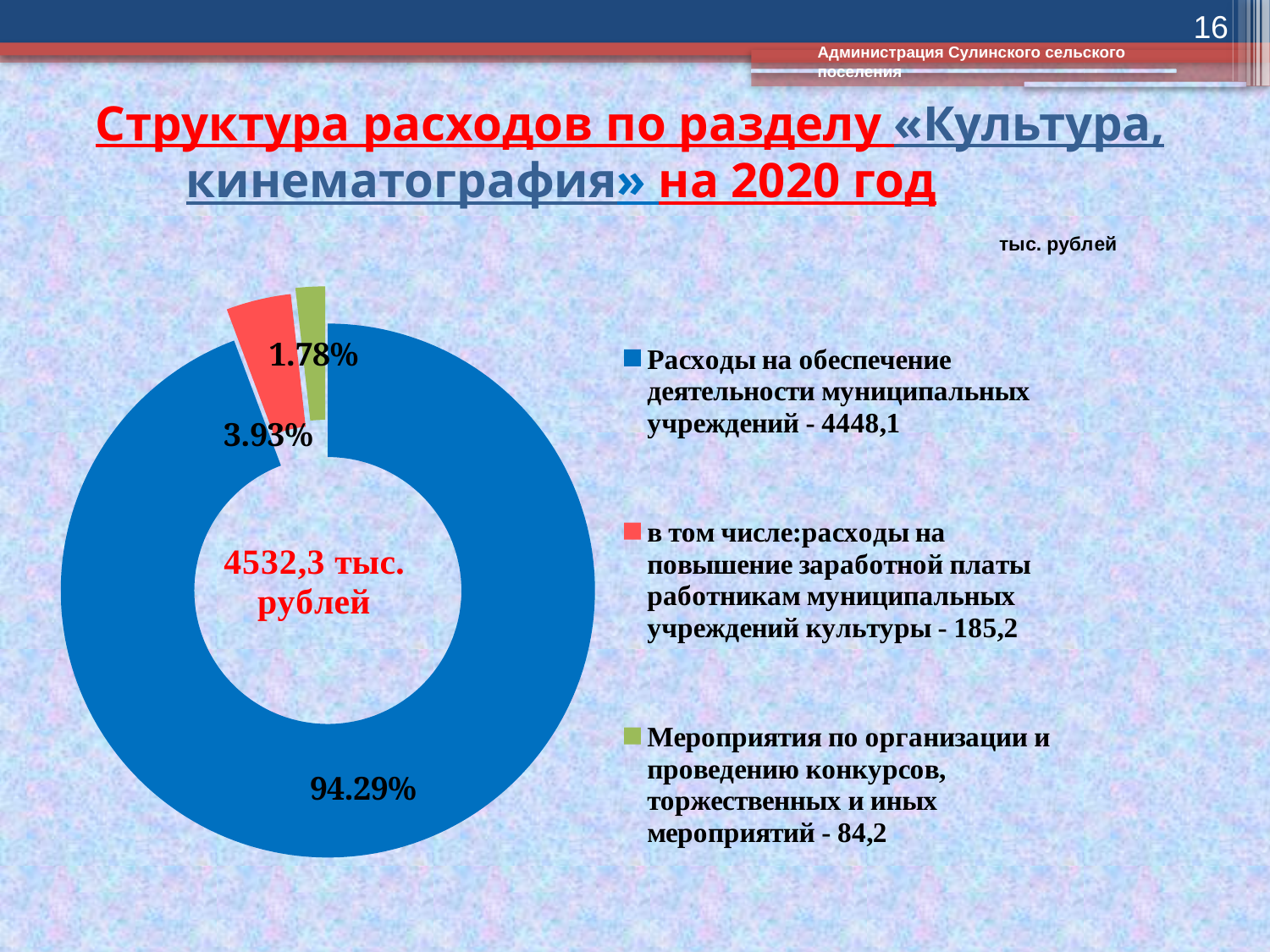
What share of the pie does the red slice represent? 3.93% What share of the pie does the largest slice (blue) represent? 94.29% What is the difference between the value for «Расходы на обеспечение деятельности муниципальных учреждений» (4448,1) and the value for «Мероприятия по организации и проведению конкурсов, торжественных и иных мероприятий» (84,2)? 4363,9 What kind of chart is shown on the slide? doughnut (pie) chart What value is given in the legend for «Расходы на обеспечение деятельности муниципальных учреждений»? 4448,1 Which category has the largest share of the chart? Расходы на обеспечение деятельности муниципальных учреждений What total amount is shown in the centre of the chart? 4532,3 тыс. рублей What value is given in the legend for «Мероприятия по организации и проведению конкурсов, торжественных и иных мероприятий»? 84,2 What value is given in the legend for «в том числе: расходы на повышение заработной платы работникам муниципальных учреждений культуры»? 185,2 What share of the pie does the green slice represent? 1.78% How many slices does the chart have? 3 Which category has the smallest share of the chart? Мероприятия по организации и проведению конкурсов, торжественных и иных мероприятий